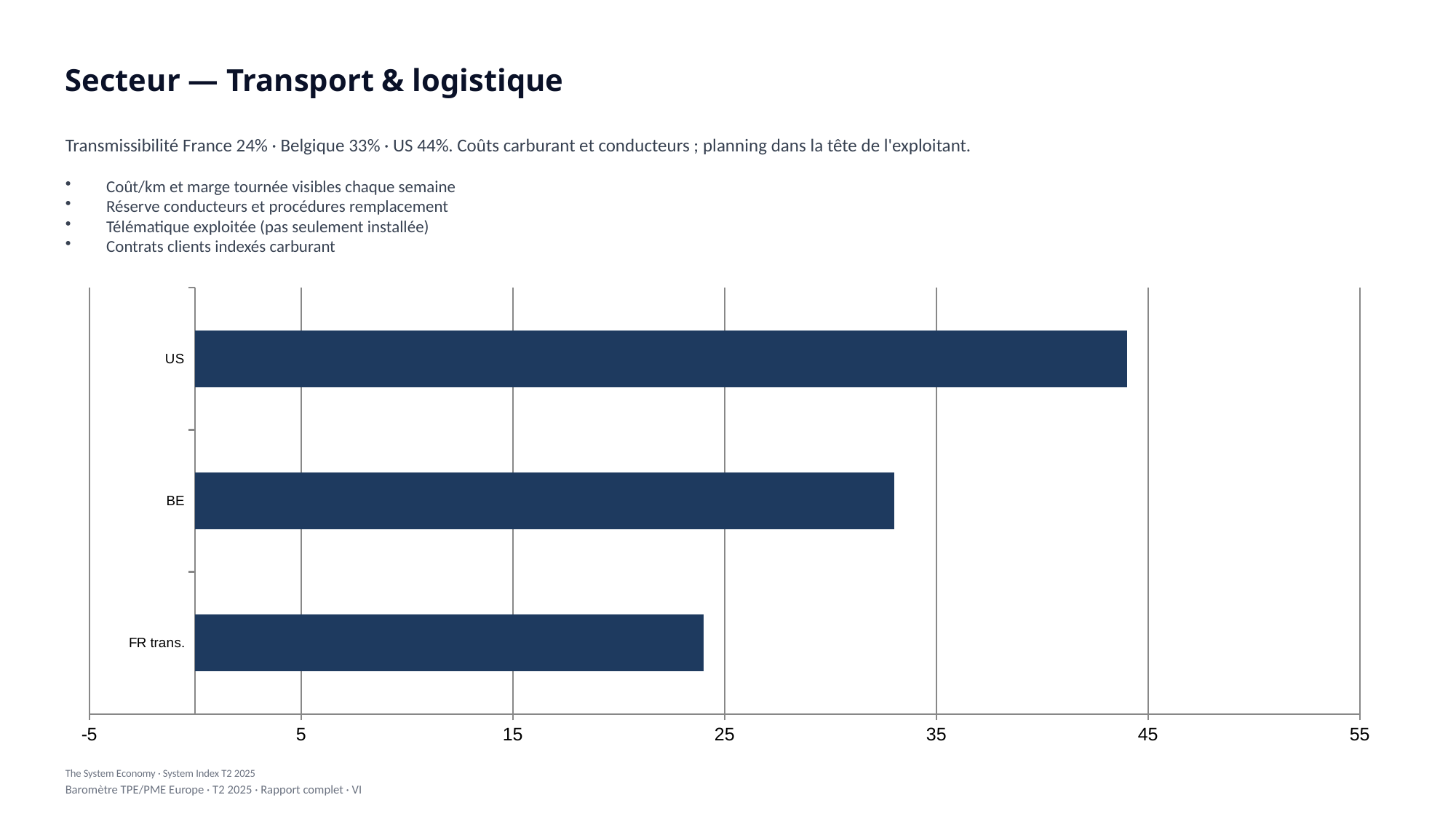
Which has the larger value, US or BE? US How many categories are plotted in the chart? 3 Which category has the highest value in the chart? US Which has the larger value, BE or FR trans.? BE Is the value for US greater or less than 45? less Which category has the lowest value in the chart? FR trans. Is the value for FR trans. greater or less than 15? greater Is the value for US greater or less than 35? greater What kind of chart is shown on the slide? bar chart What is the label of the category shown at the top of the chart? US